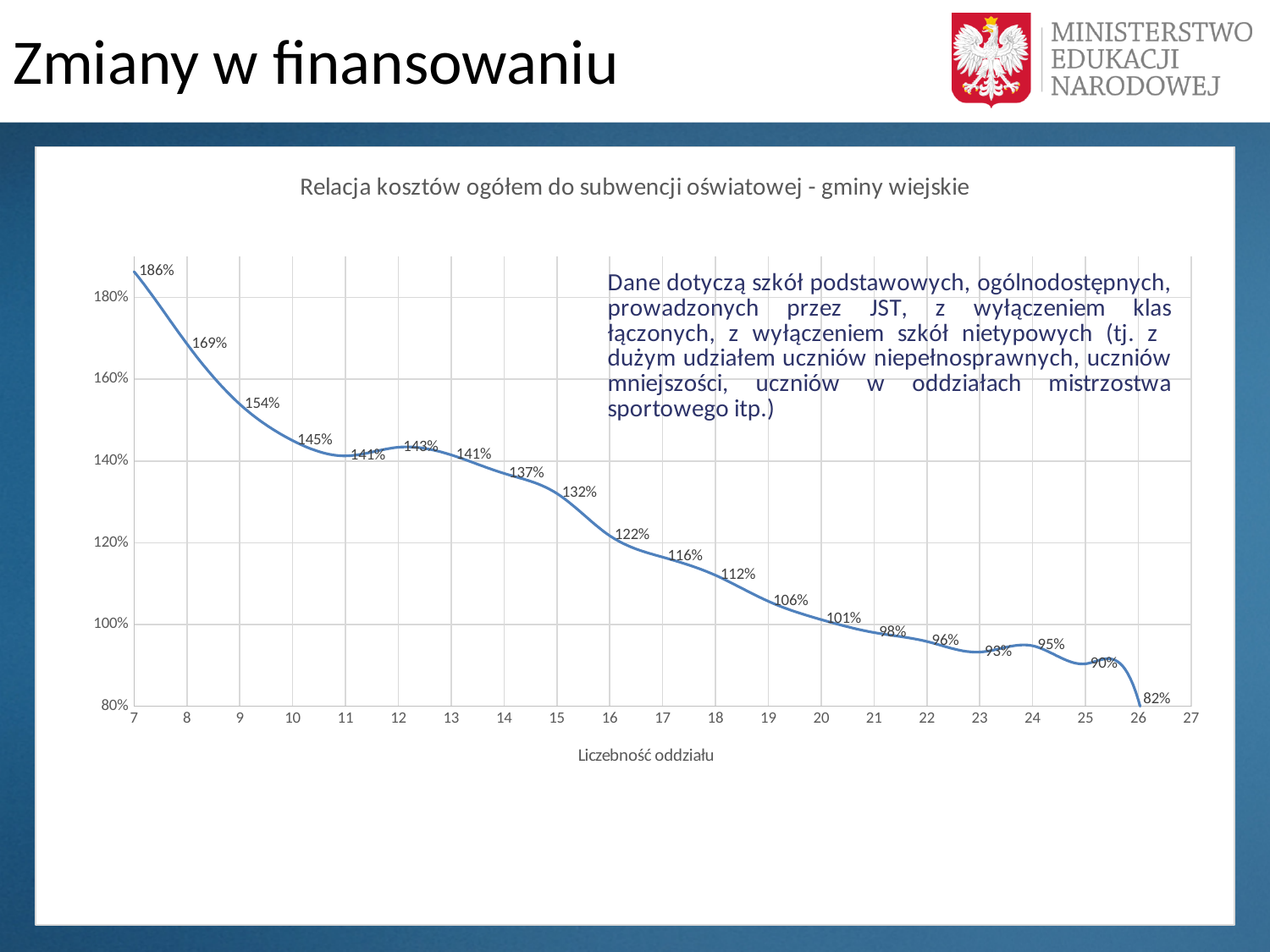
What type of chart is shown on the slide? line chart What is the value for a class size (Liczebność oddziału) of 7? 186% Is the value for class size 20 greater or less than 100%? greater How many data points are plotted on the line? 20 At which class size is the value highest? 7 Do the values generally rise or fall as class size increases along the x axis? fall At which class size is the value lowest? 26 What is the value for a class size of 16? 122% Which has a larger value: class size 12 or class size 15? class size 12 What is the title of the chart? Relacja kosztów ogółem do subwencji oświatowej - gminy wiejskie What is the value for a class size of 26? 82% What is the difference between the values for class sizes 7 and 8? 17%